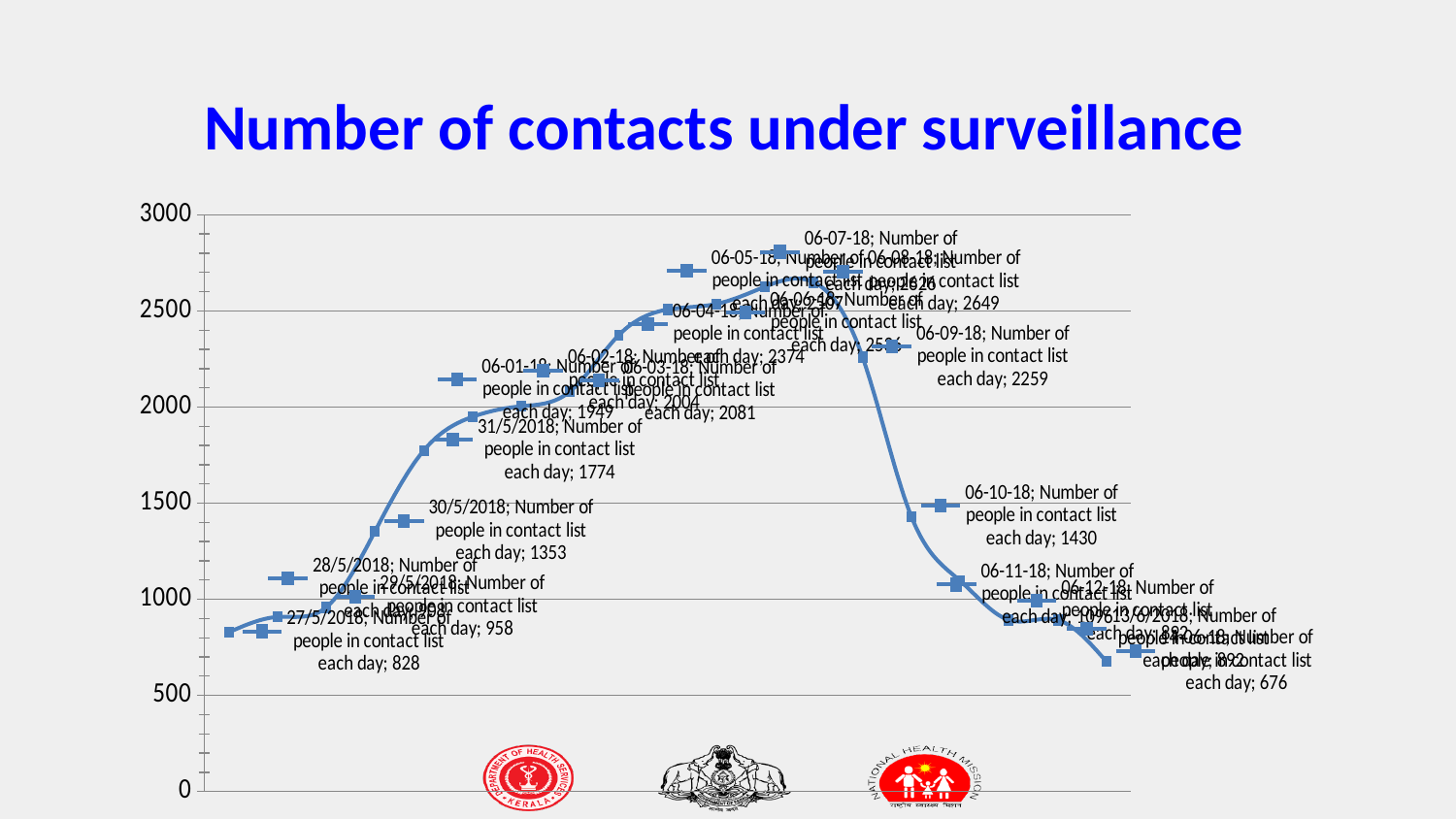
What type of chart is shown on the slide? line chart What is the number of people in the contact list on 06-14-18? 676 What is the number of people in the contact list on 06-10-18? 1430 What is the number of people in the contact list on 31/5/2018? 1774 Which date has more contacts in the list: 31/5/2018 or 06-10-18? 31/5/2018 What is the difference between the number of contacts on 06-08-18 and on 06-09-18? 390 What is the number of people in the contact list on 27/5/2018? 828 What is the number of people in the contact list on 06-04-18? 2374 What is the number of people in the contact list on 30/5/2018? 1353 On which date does the number of contacts under surveillance reach its highest value? 06-08-18 What is the title of the chart? Number of contacts under surveillance